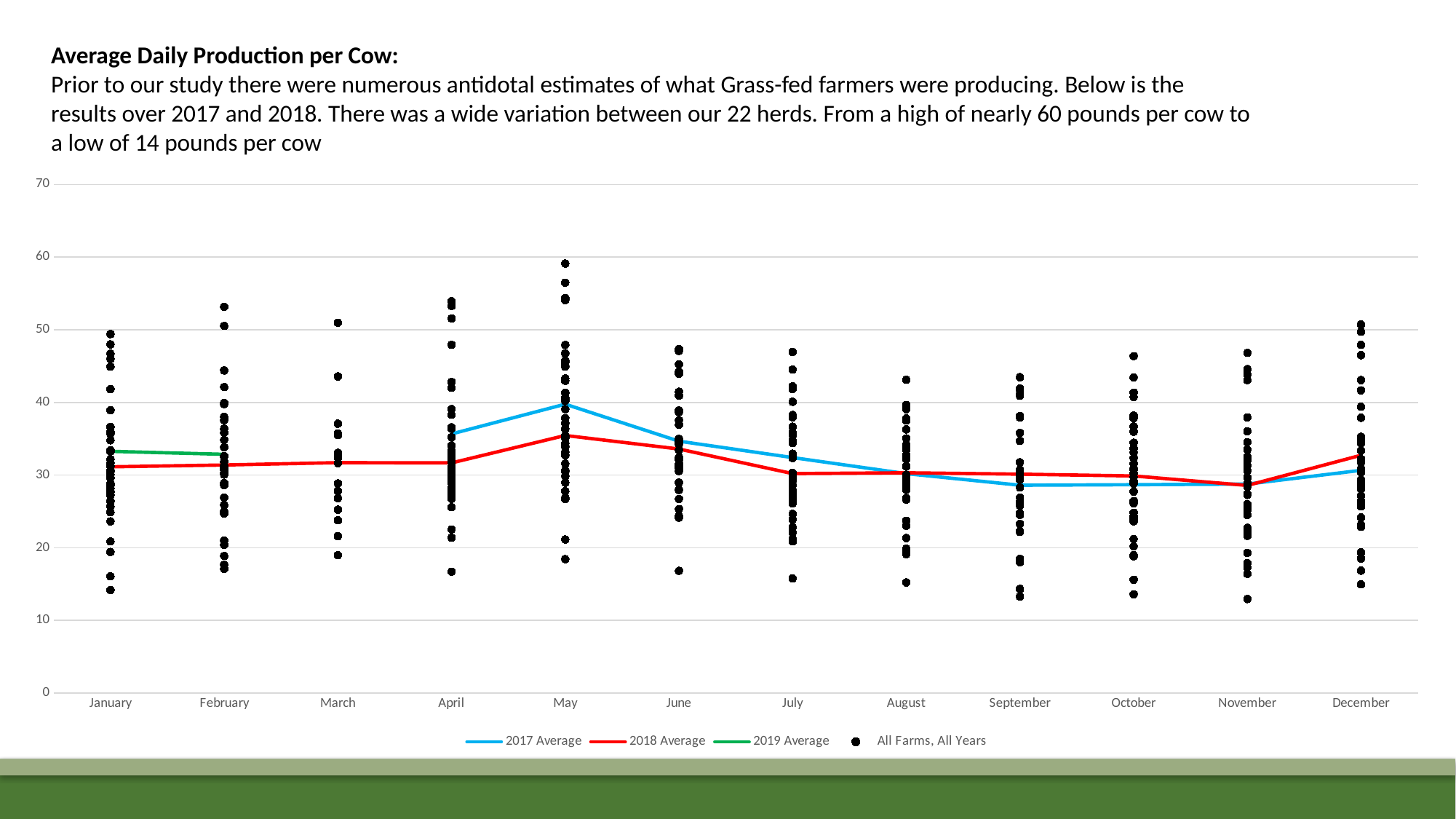
In which month does the 2017 Average line reach its highest value? May Which legend entry is drawn as black dots? All Farms, All Years In May, which is larger: the 2017 Average or the 2018 Average? 2017 Average Does the 2017 Average line rise or fall from May to September? fall How many months are shown along the x axis? 12 In which month does the 2018 Average line reach its highest value? May Is the 2017 Average value for April greater or less than 30? greater Is the 2018 Average value for January greater or less than 40? less Is the 2017 Average value for May greater or less than 30? greater In January, which is larger: the 2019 Average or the 2018 Average? 2019 Average How many series does the legend list? 4 What kind of chart is shown on the slide? line chart